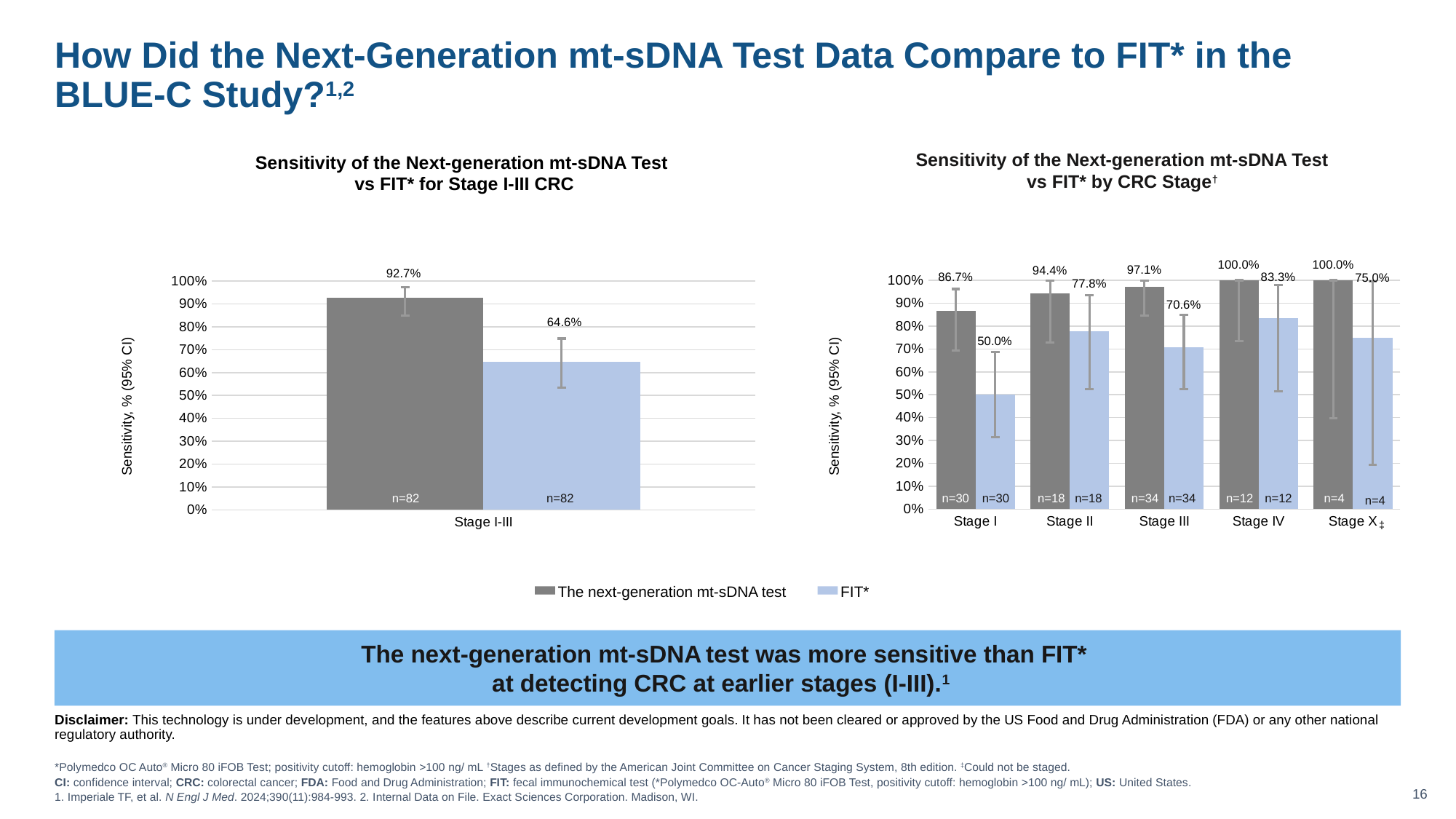
In the right chart (by CRC Stage), which is larger for Stage II: the next-generation mt-sDNA test or FIT*? The next-generation mt-sDNA test In the right chart (by CRC Stage), which stage has the lowest FIT* sensitivity? Stage I In the right chart (by CRC Stage), what is the difference between the next-generation mt-sDNA test and FIT* sensitivity for Stage III? 26.5% In the right chart (by CRC Stage), what is the sensitivity of the next-generation mt-sDNA test for Stage III? 97.1% In the right chart (by CRC Stage), what is the sensitivity of FIT* for Stage I? 50.0% In the left chart (Stage I-III CRC), what is the difference in sensitivity between the next-generation mt-sDNA test and FIT*? 28.1% In the right chart (by CRC Stage), how many stage categories are shown on the x axis? 5 How many series does the legend list? 2 In the left chart (Stage I-III CRC), what is the sensitivity of FIT*? 64.6% What kind of chart is the right chart (by CRC Stage)? Bar chart In the right chart (by CRC Stage), what is the sample size (n) for Stage IV? n=12 In the left chart (Stage I-III CRC), what is the sensitivity of the next-generation mt-sDNA test? 92.7%